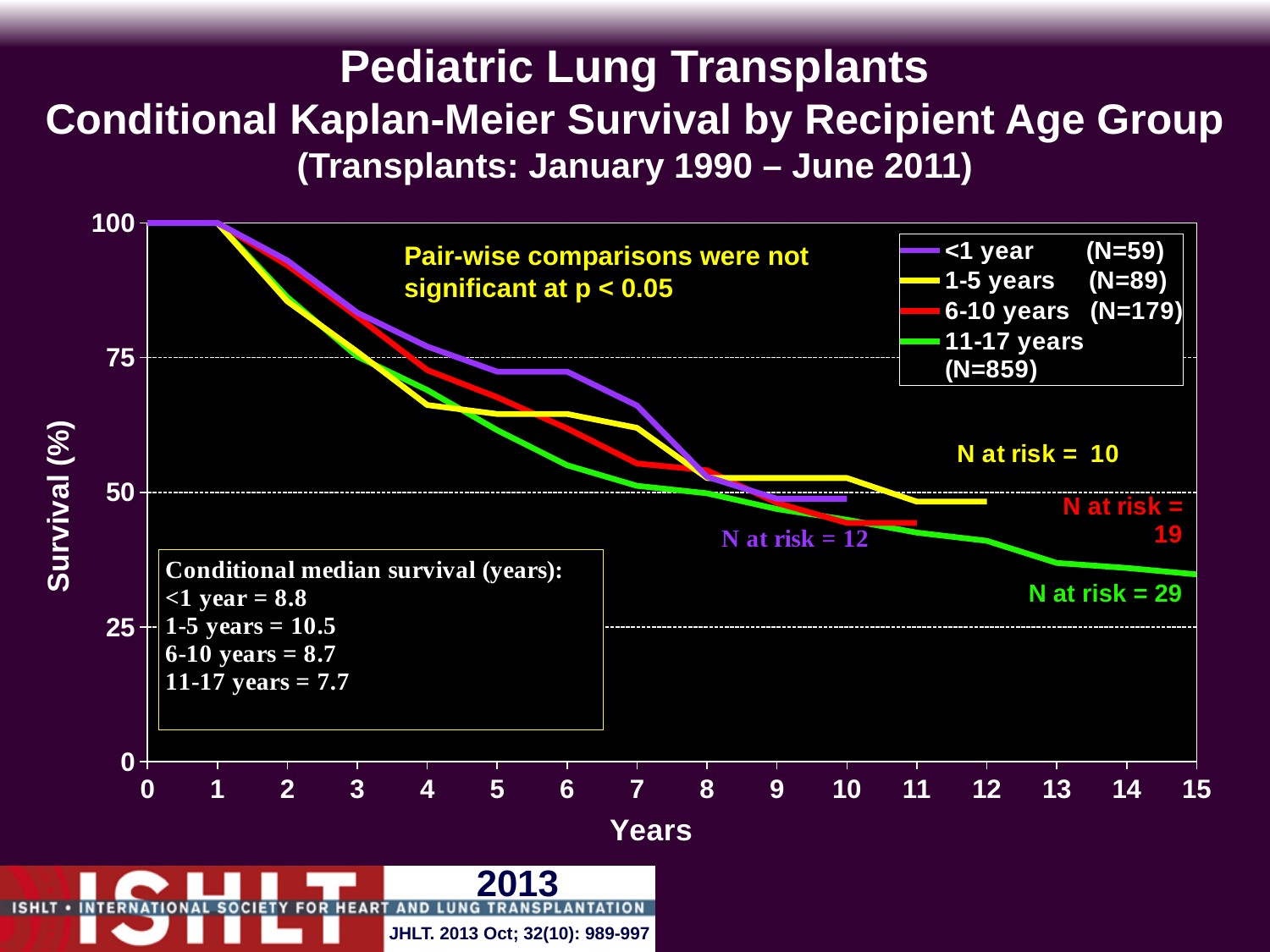
How many patients (N) are in the 6-10 years group according to the legend? 179 How many series does the legend list? 4 Which group has a larger N at risk, 6-10 years or 11-17 years? 11-17 years What kind of chart is shown on the slide? line chart Do the survival curves rise or fall as years increase? fall What is the N at risk value shown for the 11-17 years group? 29 Is the survival value for the 11-17 years group at 15 years greater or less than 50? less What is the difference in conditional median survival between the 1-5 years group and the 11-17 years group? 2.8 years Which recipient age group has the highest conditional median survival? 1-5 years What is the conditional median survival in years for the 1-5 years group? 10.5 Is the survival value for the 1-5 years group at 2 years greater or less than 75? greater Which recipient age group has the lowest conditional median survival? 11-17 years